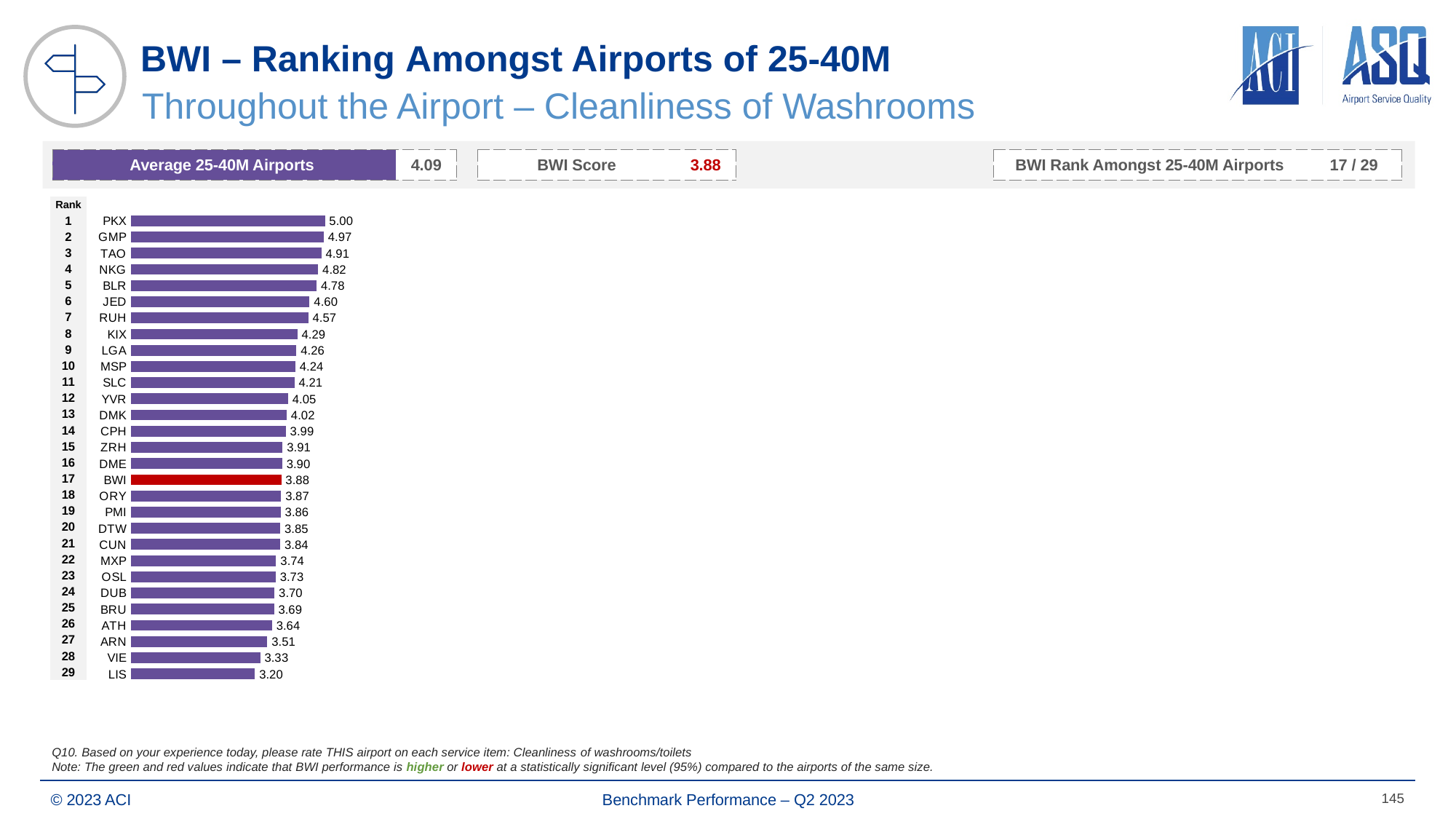
What is the score for PKX in the chart? 5.00 What is the score for BWI in the chart? 3.88 What is the score for LIS in the chart? 3.20 How many airports are ranked in the chart? 29 Which bar in the chart is coloured red? BWI Which has a higher score, JED or KIX? JED Which airport has the highest score in the chart? PKX Which airport has the lowest score in the chart? LIS What is the difference between the scores of PKX and LIS? 1.80 What is the score for ARN in the chart? 3.51 What kind of chart is shown on the slide? Bar chart What is the difference between the scores of BWI and VIE? 0.55